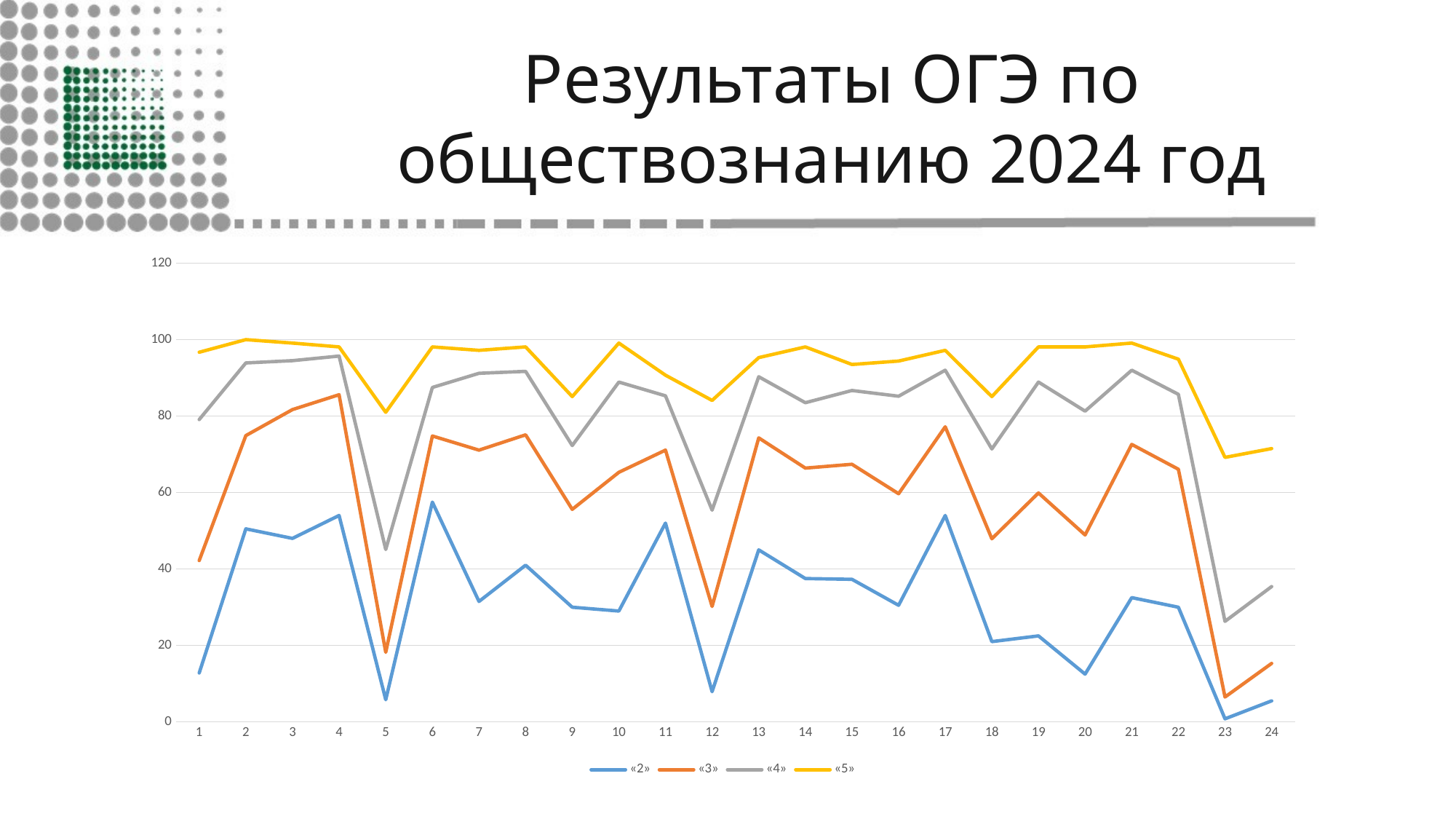
Is the value for series «2» at point 6 greater or less than 40? greater How many series does the legend list? 4 How many points are there along the x axis? 24 At point 12, which series has the larger value, «3» or «2»? «3» At which point does series «4» reach its lowest value? 23 Is the value for series «4» at point 5 greater or less than 60? less Is the value for series «2» at point 5 greater or less than 20? less Do the values of all series rise or fall from point 22 to point 23? fall What colour is the line for series «5»? yellow Which series has the highest values across all points? «5» What kind of chart is shown on the slide? line chart